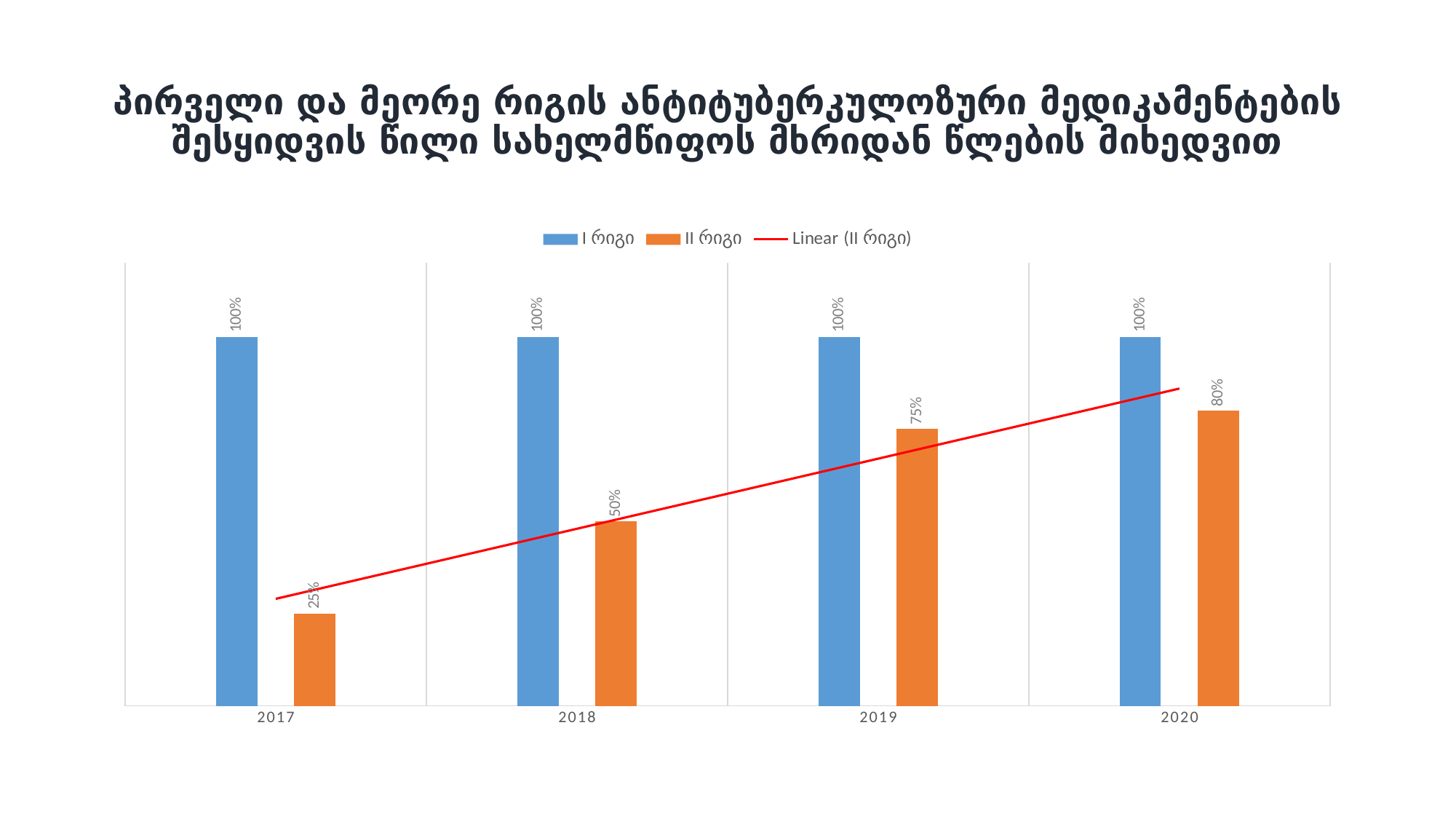
How many years are shown on the x axis? 4 What is the difference between I რიგი and II რიგი in 2018? 50% How many entries does the legend list? 3 What is the value for I რიგი in 2020? 100% What is the value for II რიგი in 2020? 80% Does the value for II რიგი rise or fall from 2017 to 2020? Rise What is the value for II რიგი in 2019? 75% What kind of chart is this? Bar chart In which year is the value for II რიგი highest? 2020 Which is larger in 2019, I რიგი or II რიგი? I რიგი In which year is the value for II რიგი lowest? 2017 What is the value for II რიგი in 2017? 25%